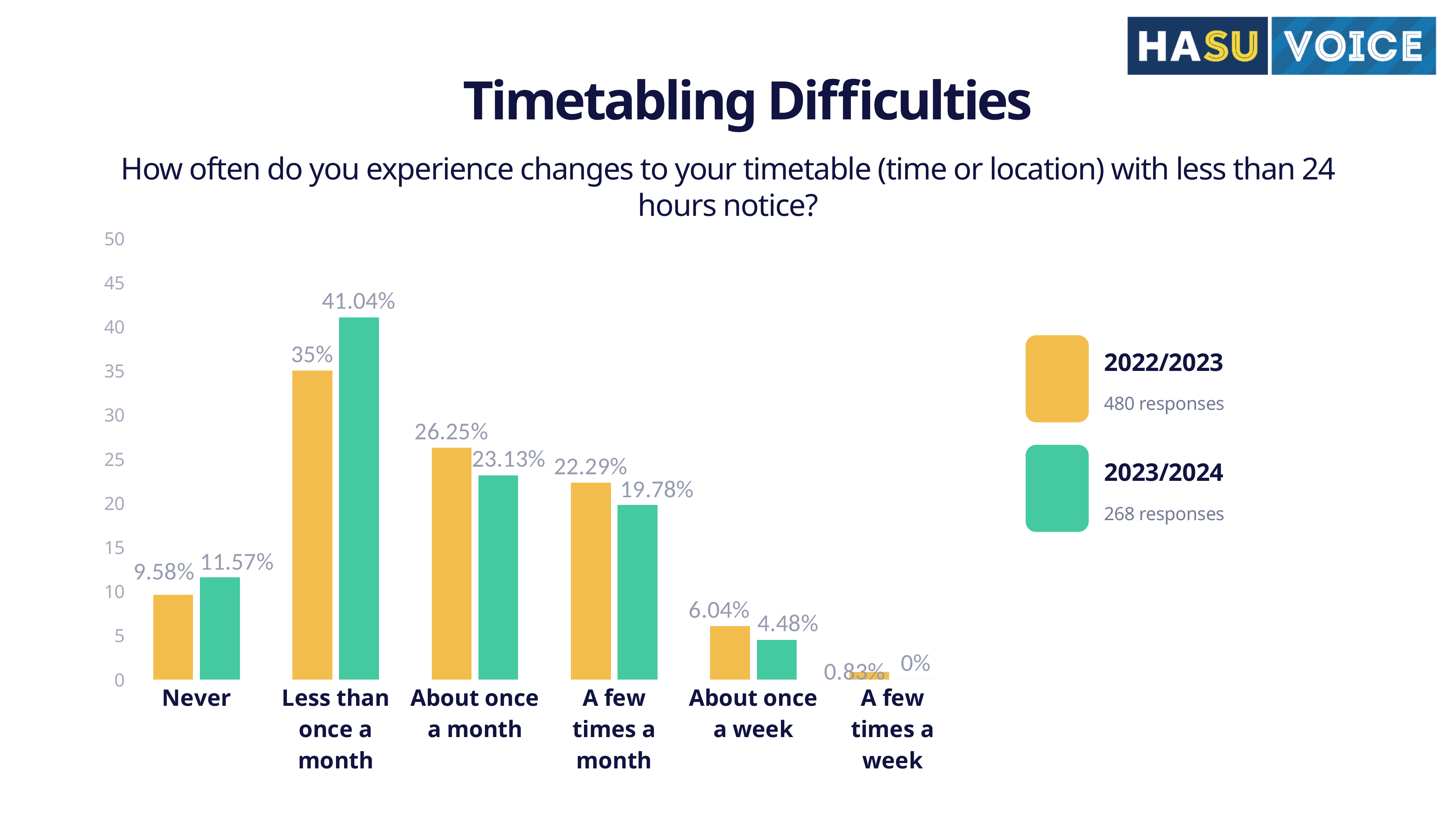
What is the 2023/2024 value for "About once a week"? 4.48% What kind of chart is shown on the slide? Bar chart What is the difference between the 2023/2024 and 2022/2023 values for "Less than once a month"? 6.04% What is the difference between the 2022/2023 and 2023/2024 values for "About once a month"? 3.12% How many series does the legend list? 2 What is the 2022/2023 value for "Less than once a month"? 35% What is the 2023/2024 value for "Never"? 11.57% Which category has the lowest 2022/2023 value? A few times a week Which category has the highest 2023/2024 value? Less than once a month For "A few times a month", which series has the larger value, 2022/2023 or 2023/2024? 2022/2023 What is the 2022/2023 value for "A few times a week"? 0.83% How many categories are shown on the x axis? 6